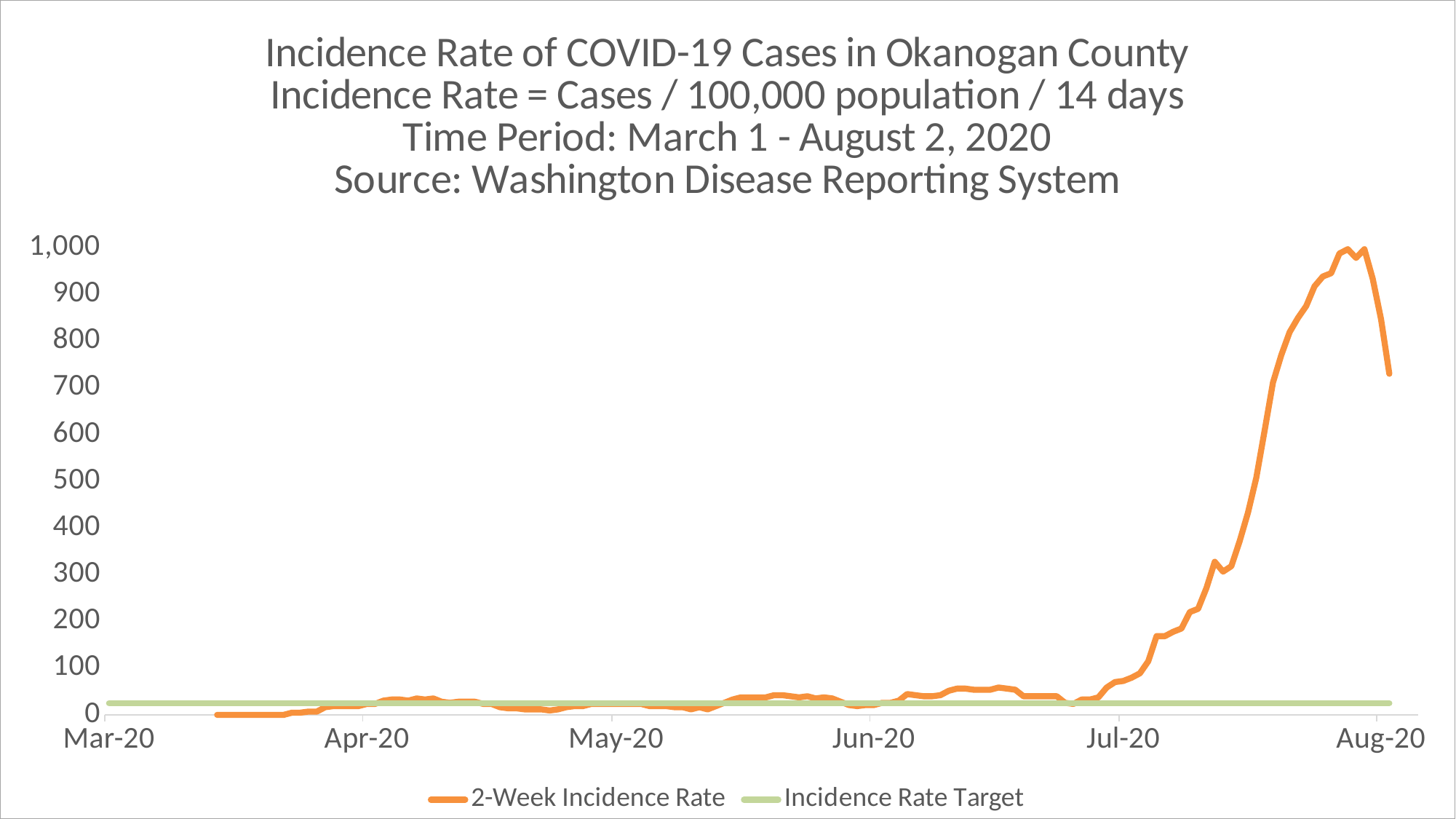
Which county does the chart title say the incidence rate is for? Okanogan County Does the 2-Week Incidence Rate rise or fall between Jul-20 and its peak in late July? rise Is the 2-Week Incidence Rate at Jun-20 greater or less than 100? less What are the two series named in the legend? 2-Week Incidence Rate; Incidence Rate Target What kind of chart is shown on the slide? line chart Is the peak value of the 2-Week Incidence Rate greater or less than 900? greater Is the 2-Week Incidence Rate at Aug-20 greater or less than 600? greater In which month does the 2-Week Incidence Rate reach its highest point? July 2020 How many series does the legend list? 2 Which is larger, the 2-Week Incidence Rate at Aug-20 or at Jul-20? Aug-20